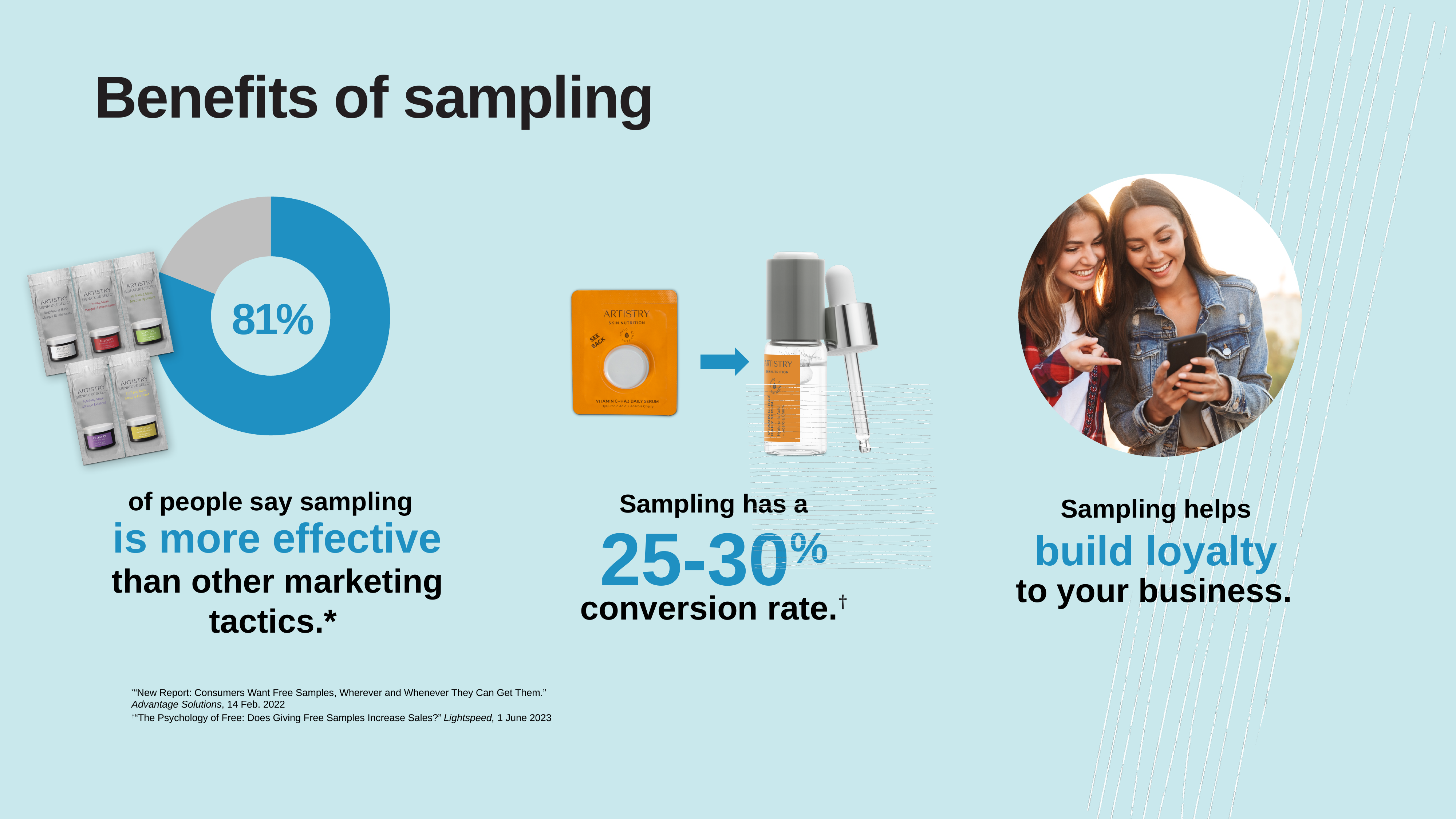
How many segments does the donut chart have? 2 What percentage is printed in the centre of the donut chart? 81% What share of the donut chart does the blue segment represent? 81% Is the blue segment of the donut chart greater or less than 50%? greater Is the grey segment of the donut chart greater or less than 50%? less What kind of chart is shown on the left of the slide? Donut (pie) chart According to the text beside the donut chart, what do 81% of people say sampling is compared with other marketing tactics? More effective What colour is the larger segment of the donut chart? Blue Which segment of the donut chart is larger, the blue one or the grey one? Blue